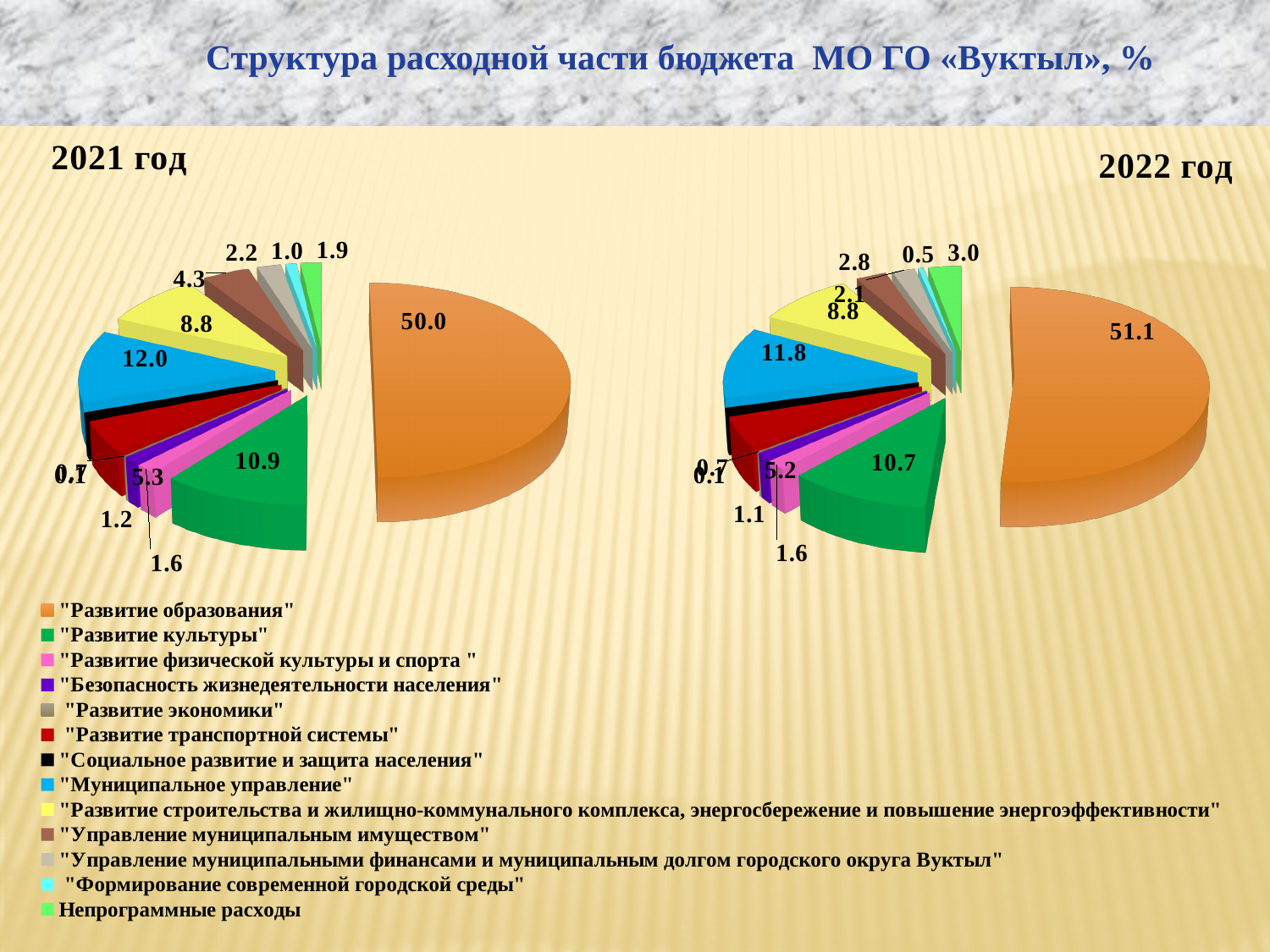
In the 2021 год pie chart, what value is labelled on the "Муниципальное управление" (blue) slice? 12.0 In the 2022 год pie chart, what value is labelled on the "Развитие культуры" (green) slice? 10.7 In the 2021 год pie chart, what percentage is shown for "Развитие образования" (the orange slice)? 50.0 In the 2022 год pie chart, what percentage is shown for "Развитие образования" (the orange slice)? 51.1 By how many percentage points did the "Развитие образования" share change from 2021 год (50.0) to 2022 год (51.1)? 1.1 In the 2021 год pie chart, which category has the largest share? "Развитие образования" In the 2021 год pie chart, what value is labelled on the "Управление муниципальным имуществом" (brown) slice? 4.3 What type of chart is used on this slide for 2021 год and 2022 год? Pie chart How many categories does the legend list? 13 What is the title of the slide? Структура расходной части бюджета МО ГО «Вуктыл», % Which is larger: the "Развитие образования" share in 2021 год or in 2022 год? 2022 год In the 2022 год pie chart, what value is labelled on the "Непрограммные расходы" (light green) slice? 3.0